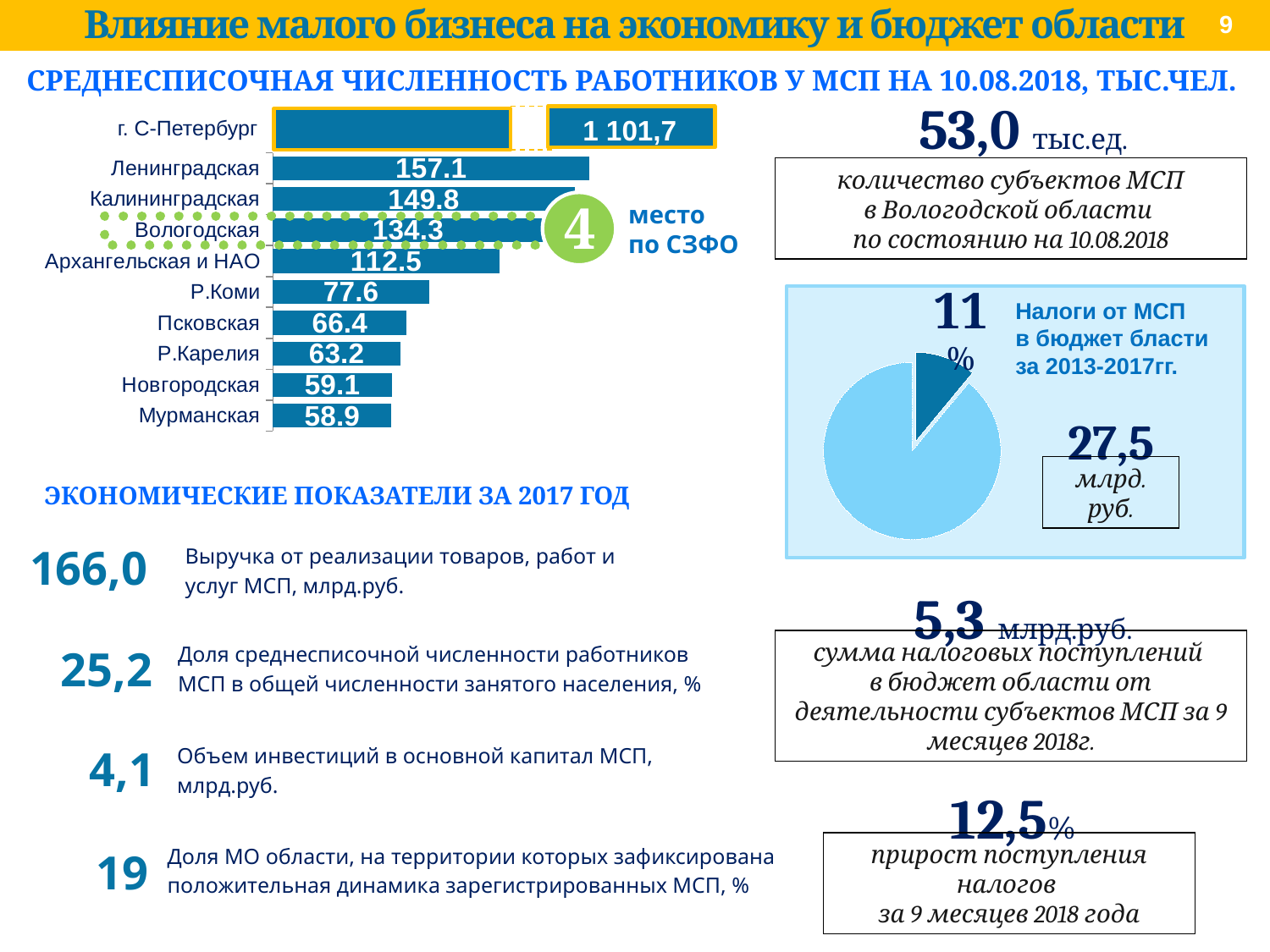
In the bar chart, what is the difference between the values for Ленинградская and Калининградская? 7.3 In the pie chart on the right, what share is shown for taxes from SMEs to the regional budget for 2013-2017? 11% What kind of chart is used to show the average number of SME employees by region? Bar chart In the bar chart, which is larger: the value for Р.Коми or for Псковская? Р.Коми How many regions are shown in the bar chart? 10 In the bar chart, what is the value for Архангельская и НАО? 112.5 In the bar chart, which region has the highest average number of SME employees? г. С-Петербург What place in the СЗФО does the bar chart indicate for Вологодская? 4 In the bar chart, which region has the lowest value? Мурманская In the bar chart of average number of employees at SMEs, what is the value for Вологодская? 134.3 In the bar chart, what is the value for г. С-Петербург? 1 101,7 In the bar chart, what is the difference between the values for Вологодская and Архангельская и НАО? 21.8